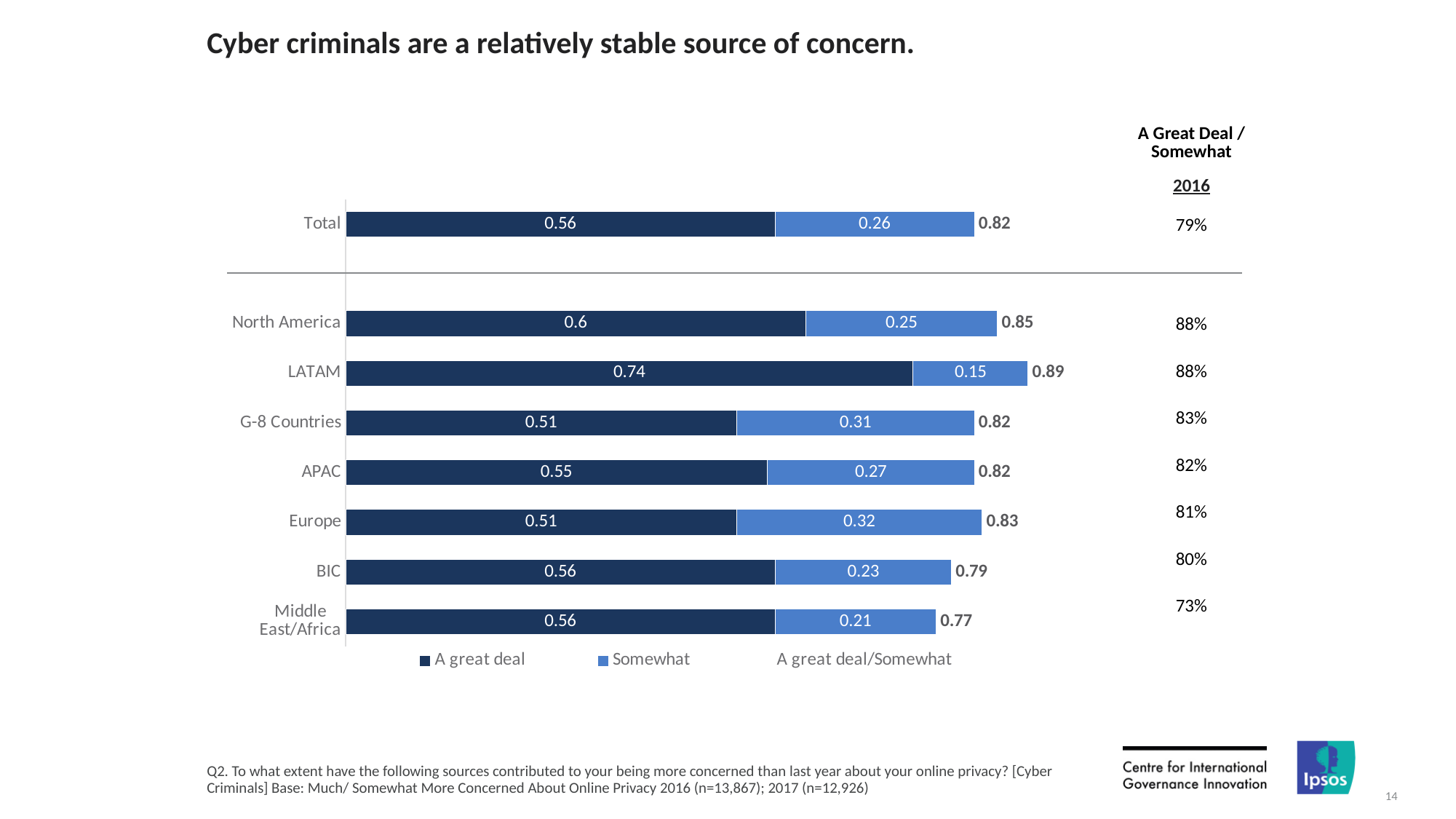
What is the combined 'A great deal/Somewhat' value shown for Middle East/Africa? 0.77 Which is larger, the 'Somewhat' value for North America or for BIC? North America What is the difference between the 'A great deal' values for LATAM and G-8 Countries? 0.23 What is the 2016 'A Great Deal / Somewhat' percentage shown for Middle East/Africa? 73% Which region has the highest 'A great deal' value? LATAM What is the 'A great deal' value for LATAM? 0.74 Which region has the lowest 'Somewhat' value? LATAM What is the 'Somewhat' value for Europe? 0.32 What is the total of the stacked bar for North America? 0.85 How many regional categories are plotted, including Total? 8 How many entries does the legend list? 3 What kind of chart is shown on the slide? Stacked bar chart